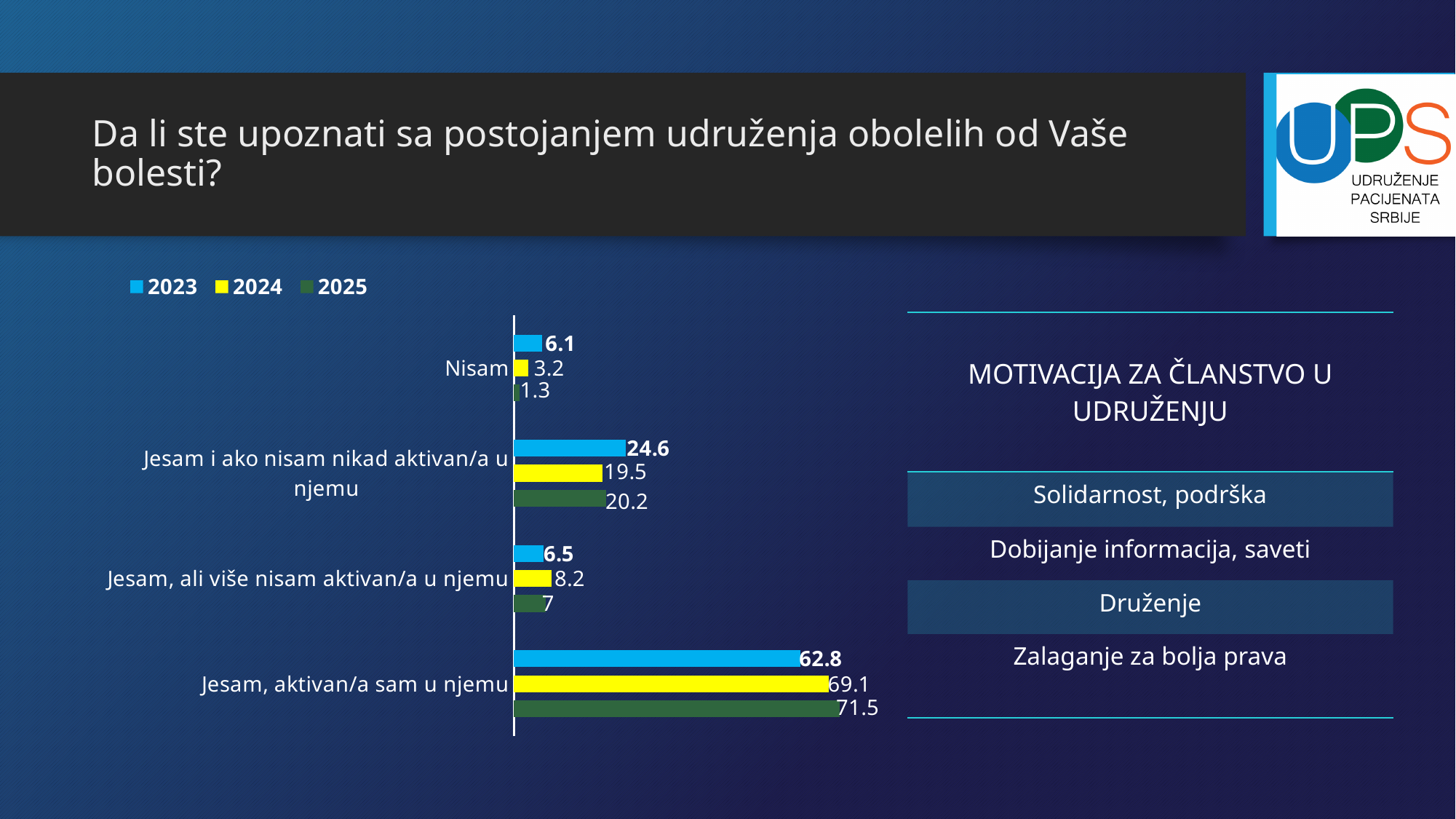
What is the 2024 value for "Jesam i ako nisam nikad aktivan/a u njemu"? 19.5 What is the 2025 value for "Jesam, aktivan/a sam u njemu"? 71.5 What kind of chart is shown on the slide? Bar chart How many series does the legend list? 3 For "Jesam, ali više nisam aktivan/a u njemu", which is larger: the 2024 value or the 2025 value? 2024 What is the 2023 value for "Nisam"? 6.1 What is the difference between the 2025 and 2023 values for "Jesam, aktivan/a sam u njemu"? 8.7 Which category has the highest 2024 value? Jesam, aktivan/a sam u njemu Which category has the lowest 2025 value? Nisam How many categories are shown on the chart? 4 What is the difference between the 2023 and 2024 values for "Nisam"? 2.9 Which series is shown in yellow in the legend? 2024